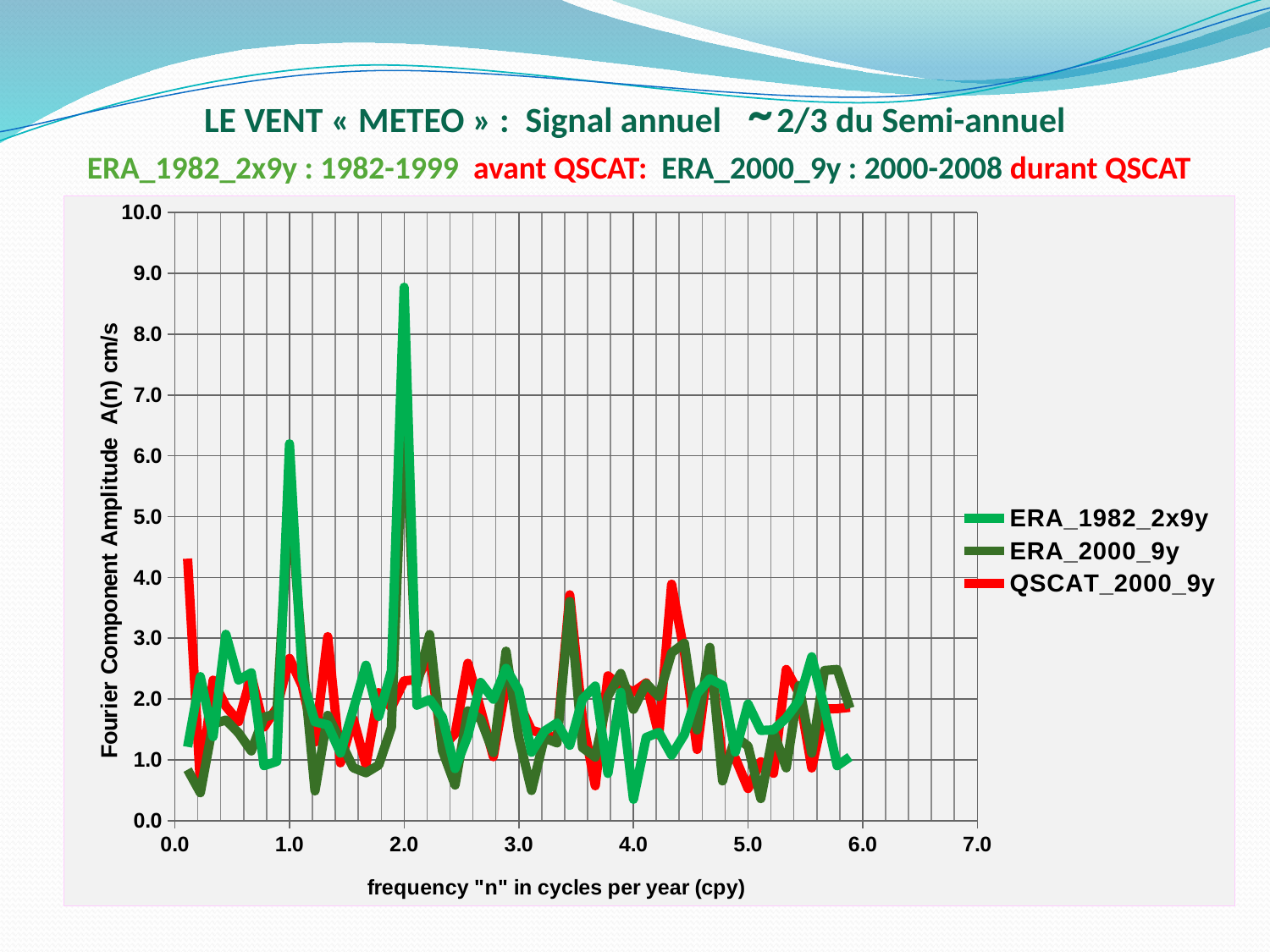
What kind of chart is shown on the slide? line chart Is the peak value of ERA_1982_2x9y at 2.0 cpy greater or less than 8.0? greater Is the value of QSCAT_2000_9y near 0.1 cpy greater or less than 3.0? greater What colour is the QSCAT_2000_9y series in the legend? red At 1.0 cpy, which series has the larger amplitude, ERA_1982_2x9y or ERA_2000_9y? ERA_1982_2x9y Which series reaches the highest amplitude anywhere on the chart? ERA_1982_2x9y What is the highest tick value shown on the y axis? 10.0 At 2.0 cpy, which series has the larger amplitude, ERA_1982_2x9y or QSCAT_2000_9y? ERA_1982_2x9y Is the peak value of ERA_1982_2x9y at 1.0 cpy greater or less than 5.0? greater How many series does the chart legend list? 3